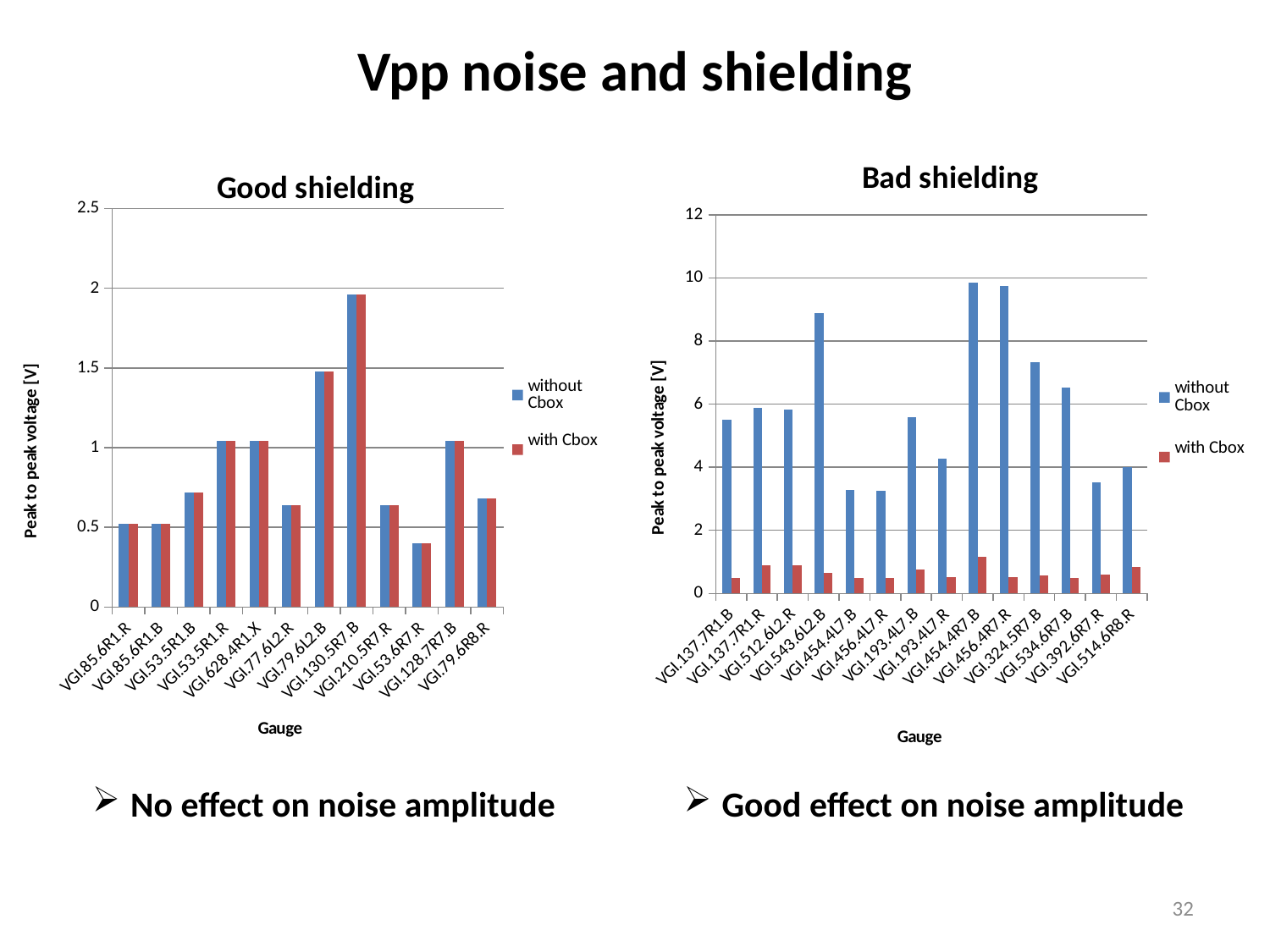
What is the y-axis label of the "Bad shielding" chart? Peak to peak voltage [V] In the "Bad shielding" chart, which gauge has the highest value with Cbox? VGI.454.4R7.B In the "Good shielding" chart, is the value for VGI.130.5R7.B without Cbox greater or less than 1.5? greater How many series does the legend of the "Bad shielding" chart list? 2 How many gauges are shown on the x axis of the "Good shielding" chart? 12 What kind of chart is the "Good shielding" chart? bar chart In the "Good shielding" chart, which gauge has the lowest peak to peak voltage? VGI.53.6R7.R In the "Bad shielding" chart, which is larger without Cbox: VGI.543.6L2.B or VGI.137.7R1.B? VGI.543.6L2.B In the "Good shielding" chart, is the value for VGI.53.6R7.R with Cbox greater or less than 0.5? less How many gauges are shown on the x axis of the "Bad shielding" chart? 14 In the "Bad shielding" chart, is the value for VGI.543.6L2.B without Cbox greater or less than 8? greater In the "Good shielding" chart, which gauge has the highest peak to peak voltage? VGI.130.5R7.B